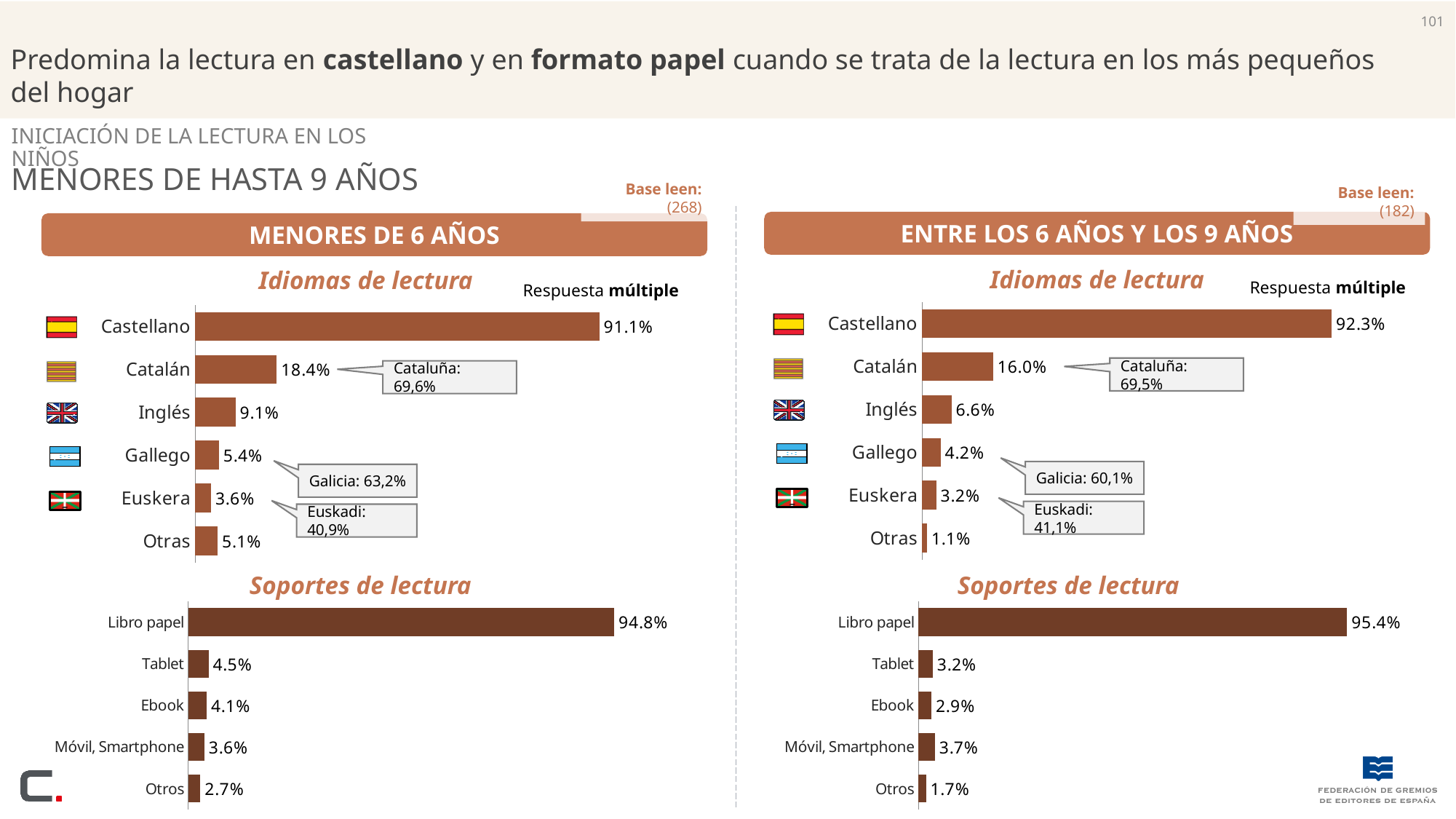
What is the 'Base leen' shown above the 'Entre los 6 años y los 9 años' section? (182) How many categories are shown in the 'Idiomas de lectura' chart for 'Entre los 6 años y los 9 años'? 6 In the 'Idiomas de lectura' chart for 'Menores de 6 años', which is larger, Gallego or Euskera? Gallego In the 'Soportes de lectura' chart for 'Entre los 6 años y los 9 años', what is the difference between Tablet and Ebook? 0.3% In the 'Soportes de lectura' chart for 'Menores de 6 años', which category has the highest value? Libro papel In the 'Idiomas de lectura' chart for 'Entre los 6 años y los 9 años', which language has the lowest value? Otras In the 'Soportes de lectura' chart for 'Entre los 6 años y los 9 años', what is the value for Libro papel? 95.4% What kind of chart is the 'Soportes de lectura' chart for 'Menores de 6 años'? Bar chart In the 'Soportes de lectura' chart for 'Menores de 6 años', what is the value for Tablet? 4.5% In the 'Idiomas de lectura' chart for 'Menores de 6 años', what is the difference between Castellano and Catalán? 72.7% In the 'Idiomas de lectura' chart for 'Menores de 6 años', what is the value for Castellano? 91.1% In the 'Idiomas de lectura' chart for 'Entre los 6 años y los 9 años', what is the value for Catalán? 16.0%